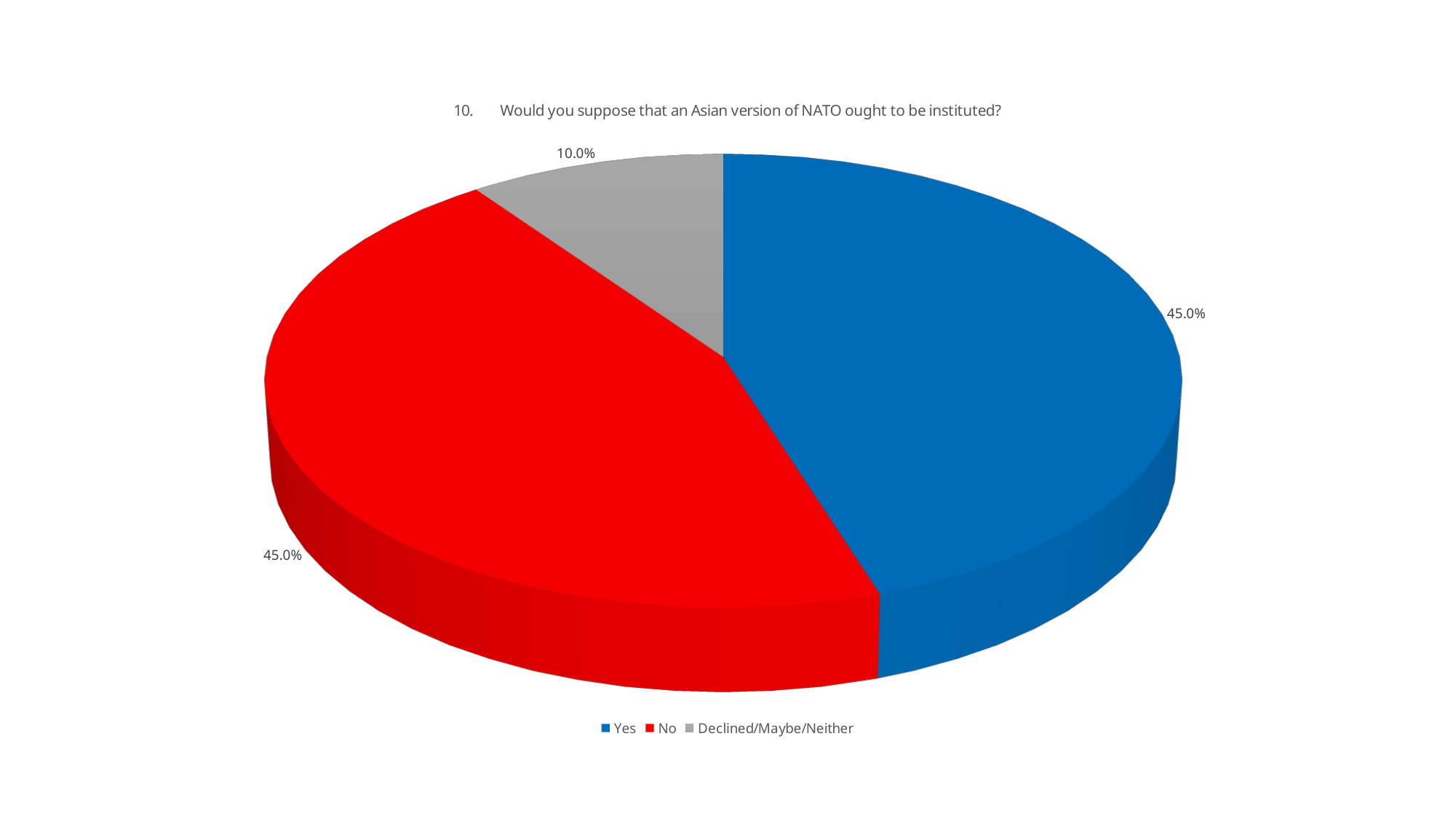
How many categories does the pie chart show? 3 What is the difference in percentage points between the Yes share and the Declined/Maybe/Neither share? 35.0% How many entries does the legend list? 3 What question is the chart titled with? Would you suppose that an Asian version of NATO ought to be instituted? What percentage of respondents answered Yes? 45.0% What percentage of respondents fall under Declined/Maybe/Neither? 10.0% Which is larger, the No share or the Declined/Maybe/Neither share? No What colour represents the No category? Red What is the combined share of Yes and No? 90.0% What kind of chart is shown on the slide? Pie chart Which category has the smallest share of the pie? Declined/Maybe/Neither What percentage of respondents answered No? 45.0%